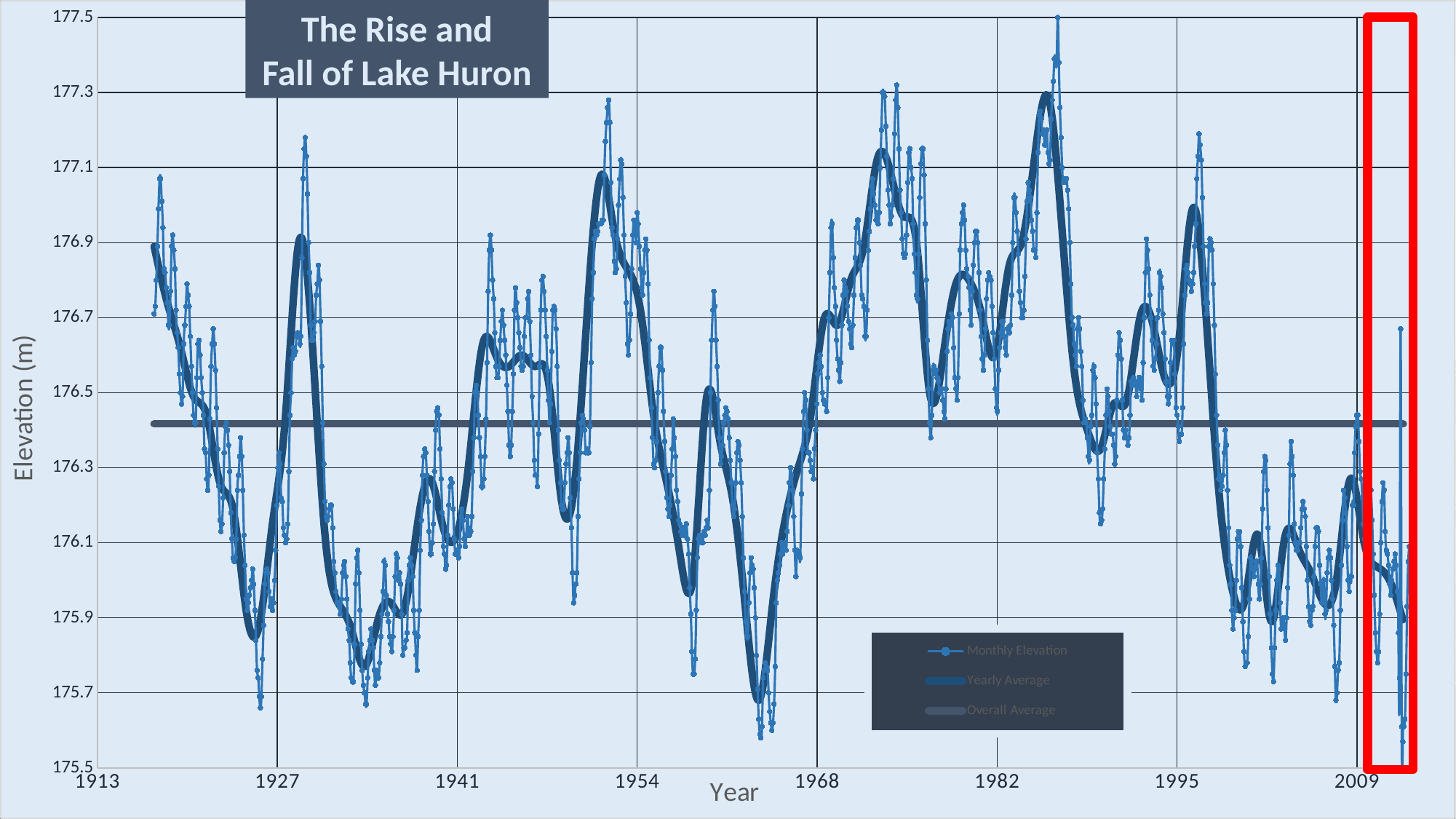
Is the Yearly Average at 1954 greater or less than 176.5? greater Is the Overall Average line greater or less than 176.5? less What are the three series named in the legend? Monthly Elevation, Yearly Average, Overall Average Is the highest Monthly Elevation value greater or less than 177.3? greater How many year labels are shown on the x axis? 8 How many series does the legend list? 3 What is the title of the chart? The Rise and Fall of Lake Huron Does the Yearly Average rise or fall overall between 1995 and 2009? fall What kind of chart is shown on the slide? line chart